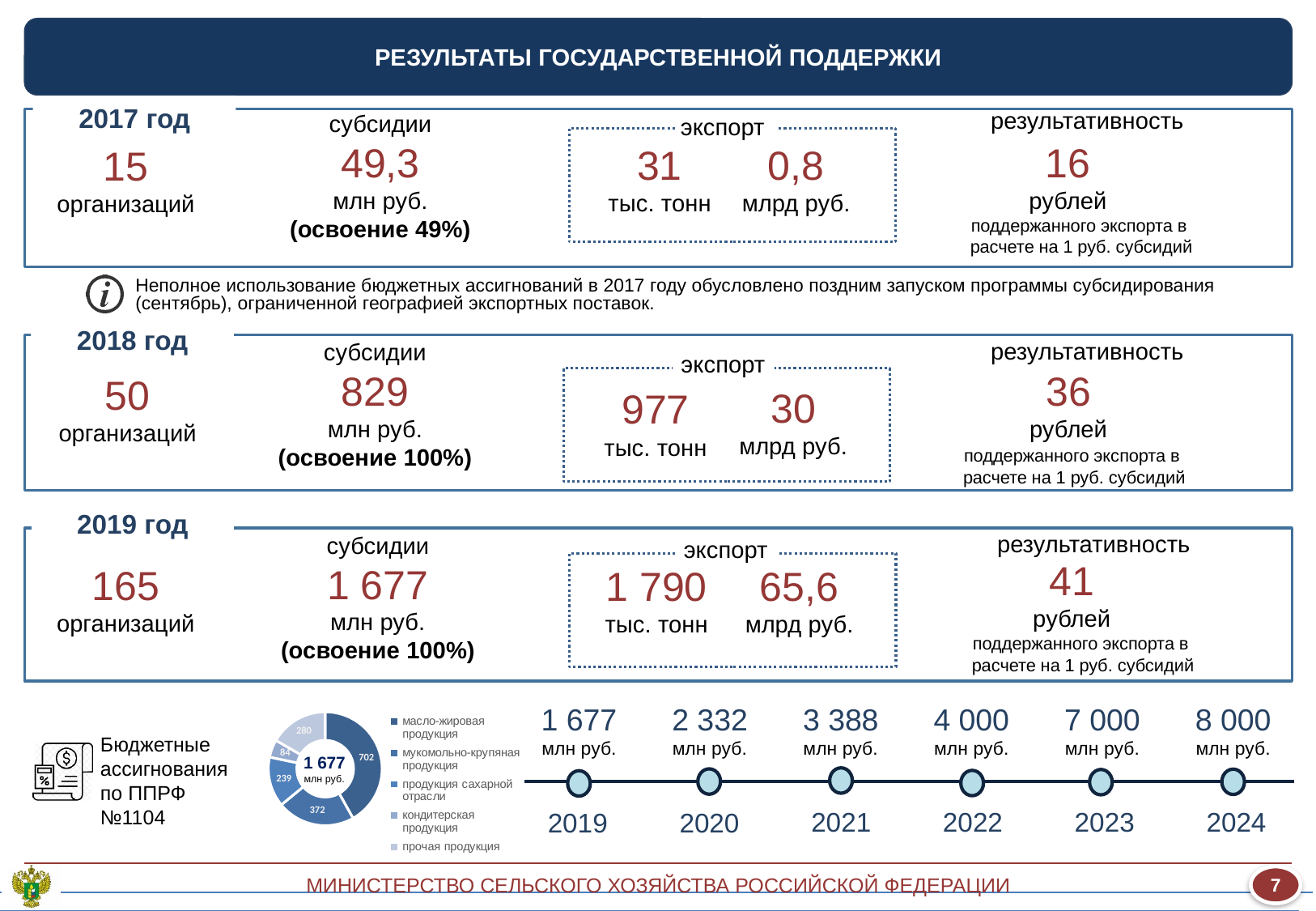
What is the value of the slice for кондитерская продукция on the donut chart? 84 What total is printed in the centre of the donut chart? 1 677 млн руб. What is the smallest value shown on the donut chart? 84 What is the value of the slice for масло-жировая продукция on the donut chart? 702 How many entries does the legend of the donut chart list? 5 What is the value of the slice for мукомольно-крупяная продукция on the donut chart? 372 What kind of chart is shown at the bottom of the slide next to the legend? Pie (donut) chart What is the difference between the largest slice (702) and the smallest slice (84) on the donut chart? 618 On the donut chart, which is larger: the slice labelled 280 or the slice labelled 239? 280 How many slices does the donut chart have? 5 Which legend entry is listed first for the donut chart? масло-жировая продукция What is the largest value shown on the donut chart? 702